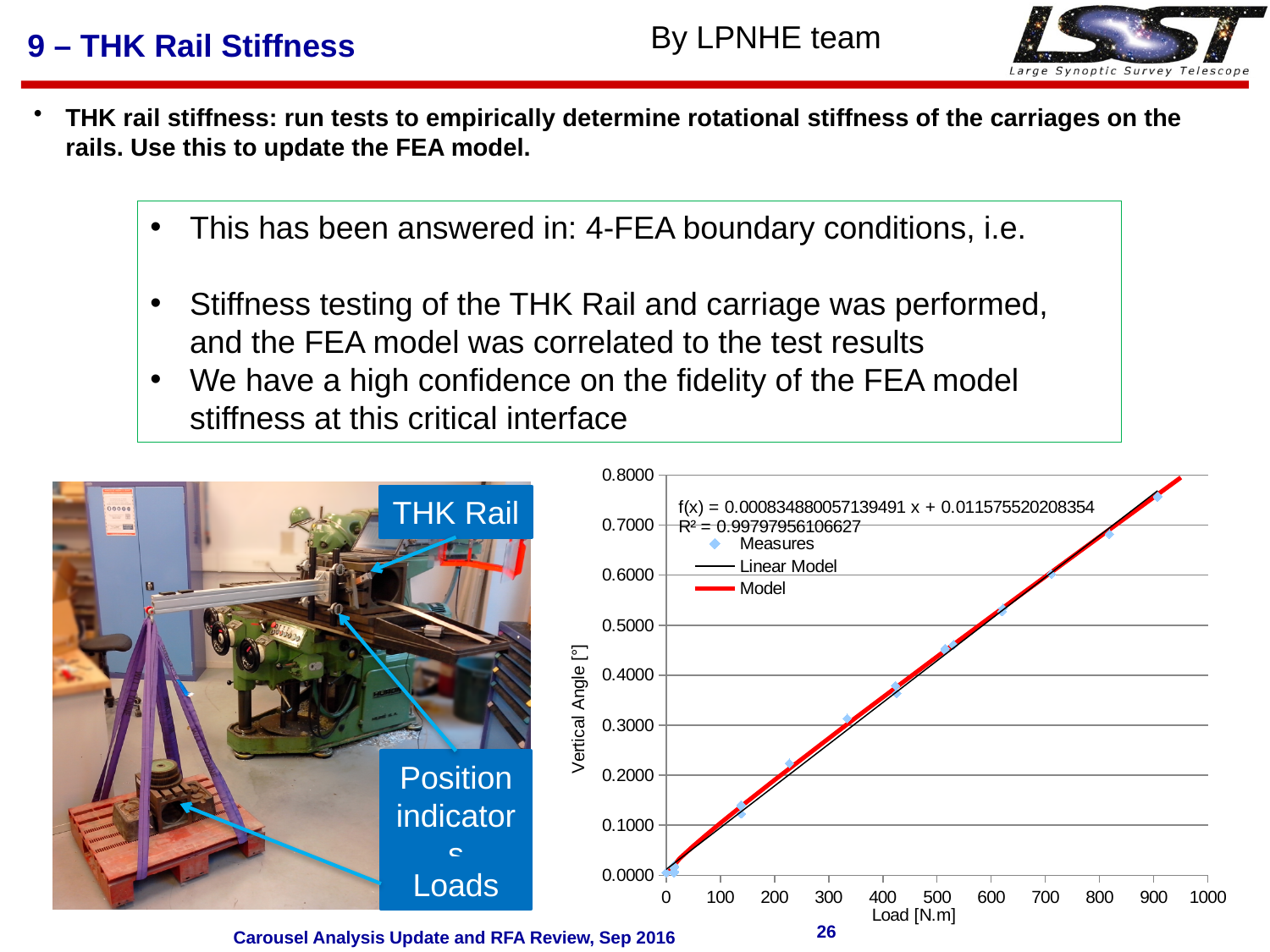
Is the measured vertical angle at a load of about 200 N.m greater or less than 0.3000? less What kind of chart is shown on the slide? scatter chart What R² value is printed on the chart? 0.99797956106627 Is the measured vertical angle at a load of about 800 N.m greater or less than 0.7000? less Is the measured vertical angle at a load of about 400 N.m greater or less than 0.3000? greater Does the vertical angle rise or fall as the load increases along the x axis? rise How many series does the chart legend list? 3 What is the title of the x axis of the chart? Load [N.m]